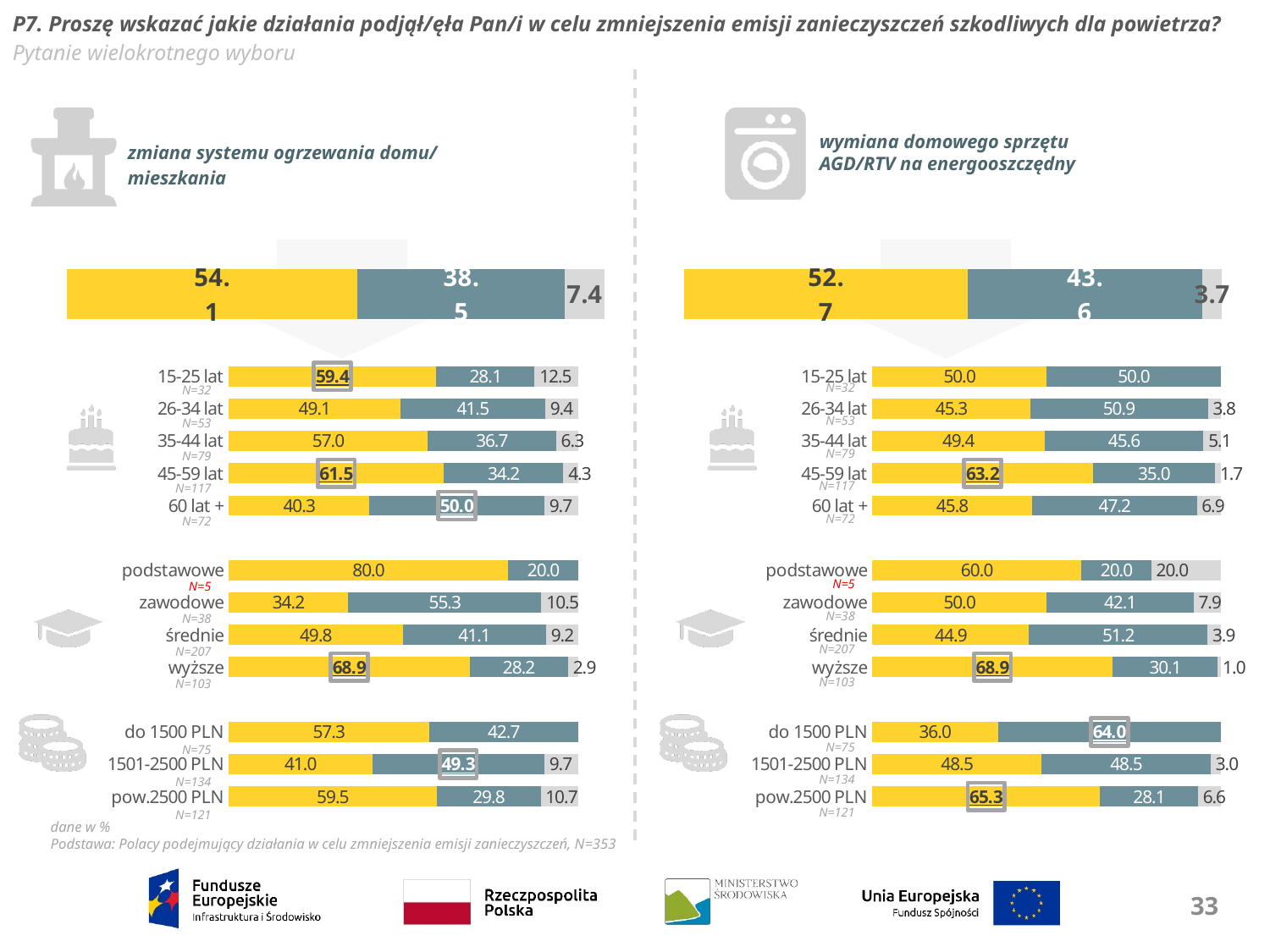
In the chart 'zmiana systemu ogrzewania domu/mieszkania', what is the value of the grey segment in the top summary bar? 7.4 In the chart 'wymiana domowego sprzętu AGD/RTV na energooszczędny', what is the blue-grey segment value for the 'do 1500 PLN' group? 64.0 What type of chart is used on this slide? Stacked bar chart In the chart 'zmiana systemu ogrzewania domu/mieszkania', what is the difference between the yellow segment values for 'wyższe' and 'zawodowe'? 34.7 In the chart 'wymiana domowego sprzętu AGD/RTV na energooszczędny', what is the yellow segment value for the 45-59 lat group? 63.2 In the chart 'zmiana systemu ogrzewania domu/mieszkania', which education group has the highest yellow segment value? podstawowe In the chart 'zmiana systemu ogrzewania domu/mieszkania', what is the yellow segment value for the 15-25 lat group? 59.4 In the chart 'wymiana domowego sprzętu AGD/RTV na energooszczędny', which age group has the lowest yellow segment value? 26-34 lat In the chart 'wymiana domowego sprzętu AGD/RTV na energooszczędny', what is the total of the three segments in the top summary bar? 100.0 In the chart 'wymiana domowego sprzętu AGD/RTV na energooszczędny', which is larger: the yellow segment for 'pow.2500 PLN' or for '1501-2500 PLN'? pow.2500 PLN In the chart 'zmiana systemu ogrzewania domu/mieszkania', how many age groups are shown? 5 In the chart 'zmiana systemu ogrzewania domu/mieszkania', what is the grey segment value for the 60 lat + group? 9.7